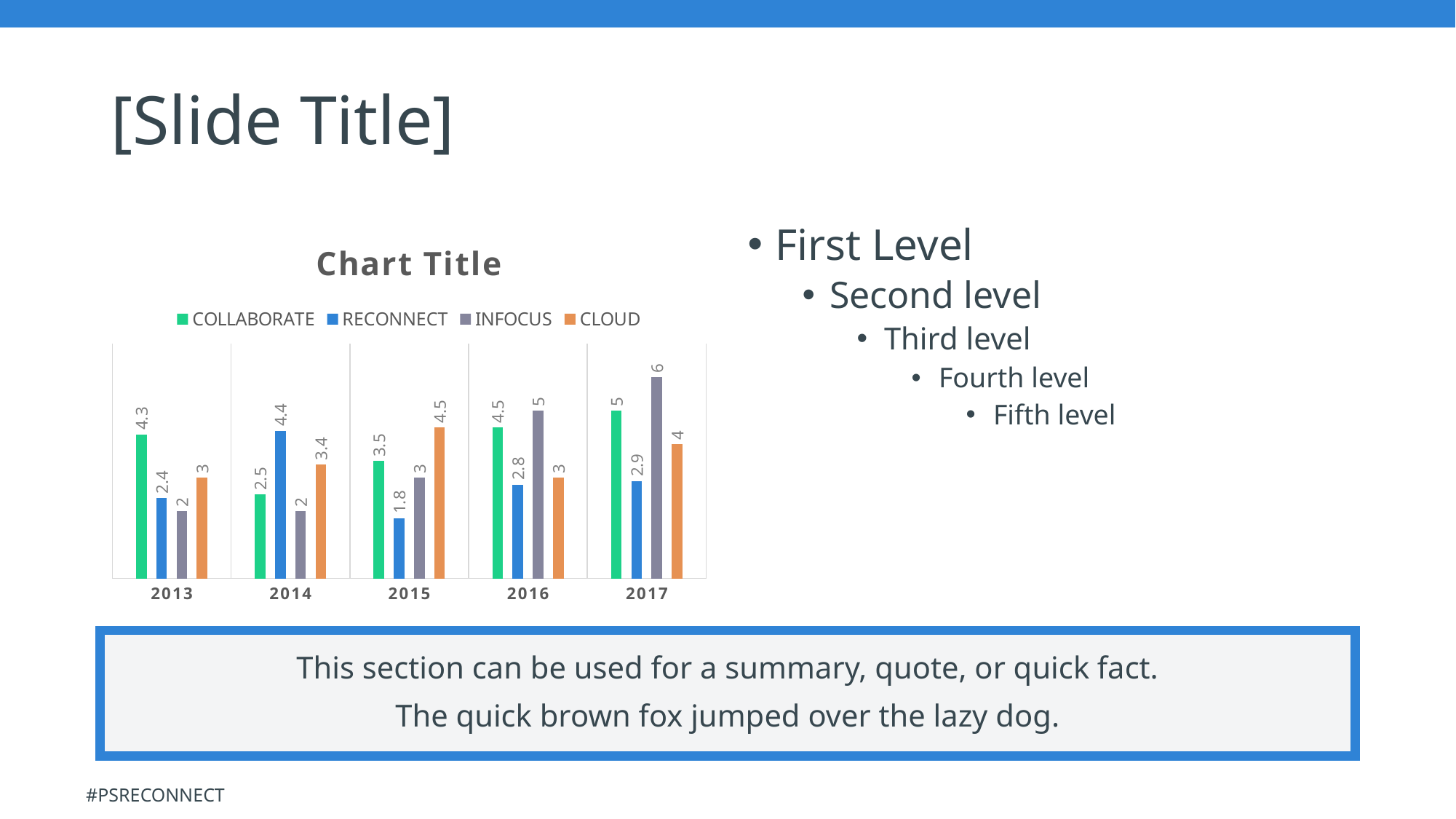
How many years are shown on the x axis? 5 Does the INFOCUS value rise or fall from 2015 to 2017? Rise How many series does the legend list? 4 What is the value for CLOUD in 2015? 4.5 What is the difference between the INFOCUS value in 2017 and the INFOCUS value in 2013? 4 What is the value for RECONNECT in 2016? 2.8 In which year is the RECONNECT value highest? 2014 What is the value for INFOCUS in 2017? 6 In which year is the RECONNECT value lowest? 2015 What kind of chart is shown on the slide? Bar chart Which is larger in 2016, COLLABORATE or INFOCUS? INFOCUS What is the value for COLLABORATE in 2013? 4.3